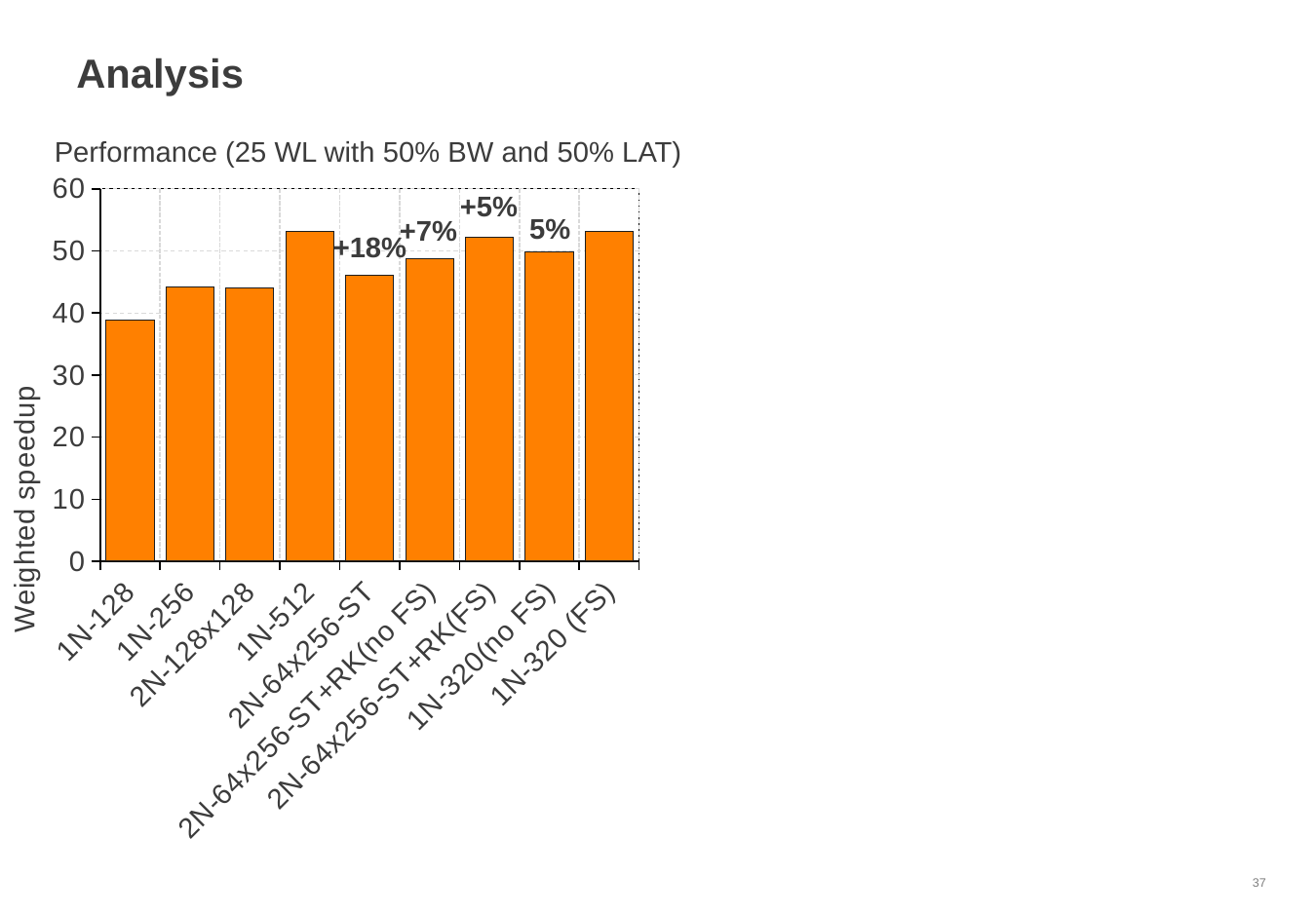
Is the weighted speedup for 1N-320 (FS) greater or less than 50? greater Is the weighted speedup for 1N-512 greater or less than 50? greater What kind of chart is shown on the slide? bar chart How many bars (categories) are plotted in the chart? 9 Which category has the lowest weighted speedup? 1N-128 Is the weighted speedup for 2N-64x256-ST greater or less than 50? less What is the title of the chart? Performance (25 WL with 50% BW and 50% LAT) What percentage annotation is printed above the 2N-64x256-ST bar? +18% Which has a higher weighted speedup, 1N-320(no FS) or 1N-320 (FS)? 1N-320 (FS) Which has a higher weighted speedup, 1N-512 or 1N-128? 1N-512